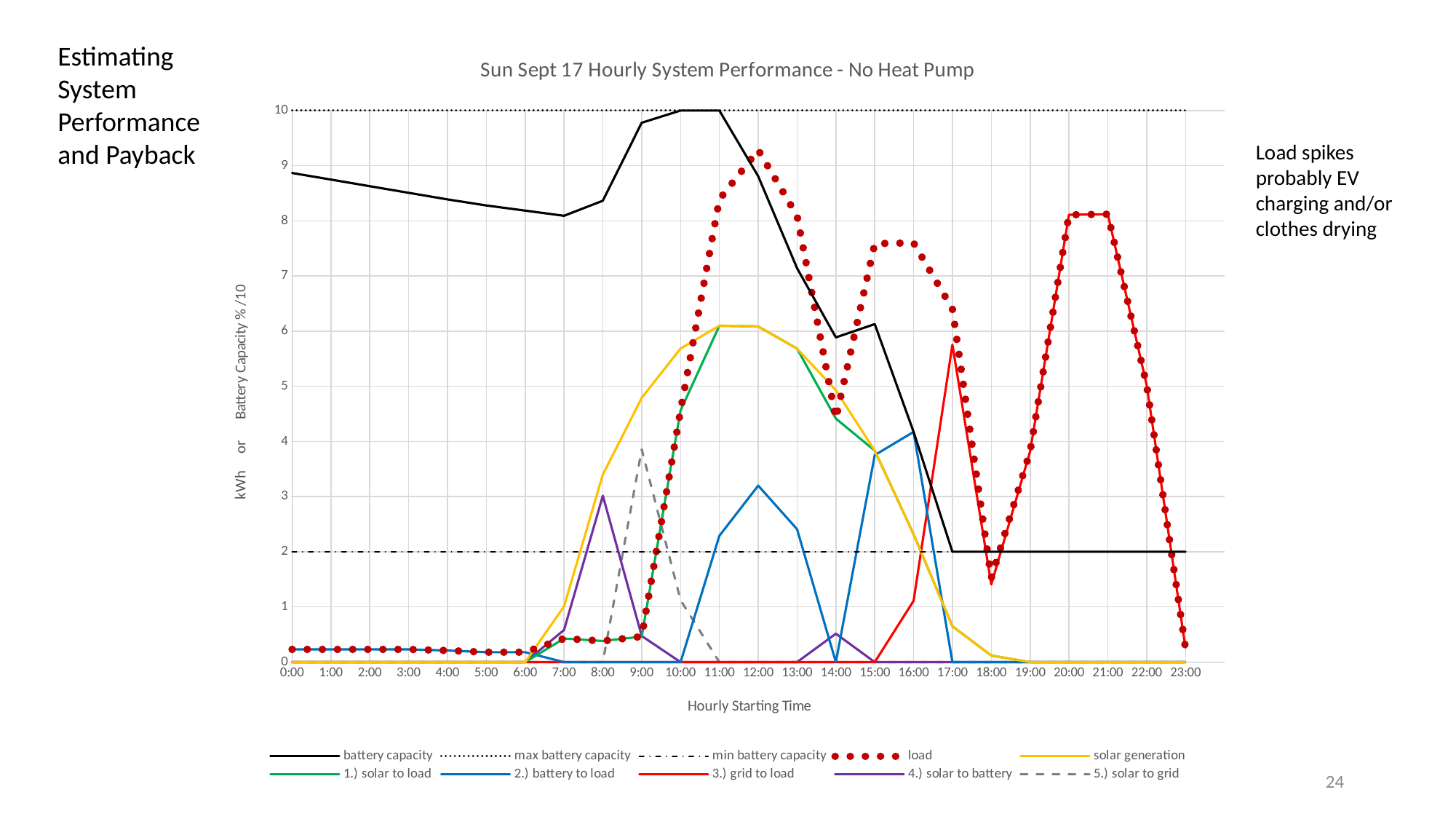
What kind of chart is shown on the slide? line chart Is the grid to load value at 17:00 greater or less than 5? greater How many hourly starting times are shown along the x axis? 24 What is the title of the chart? Sun Sept 17 Hourly System Performance - No Heat Pump What value does the max battery capacity line sit at? 10 Does the battery capacity series rise or fall between 11:00 and 18:00? fall Is the load value at 18:00 greater or less than 2? less Is the battery capacity value at 0:00 greater or less than 8? greater What value does the min battery capacity line sit at? 2 At which hour does the load series reach its highest value? 12:00 How many series does the chart's legend list? 10 Which is larger, the load at 12:00 or the load at 15:00? load at 12:00